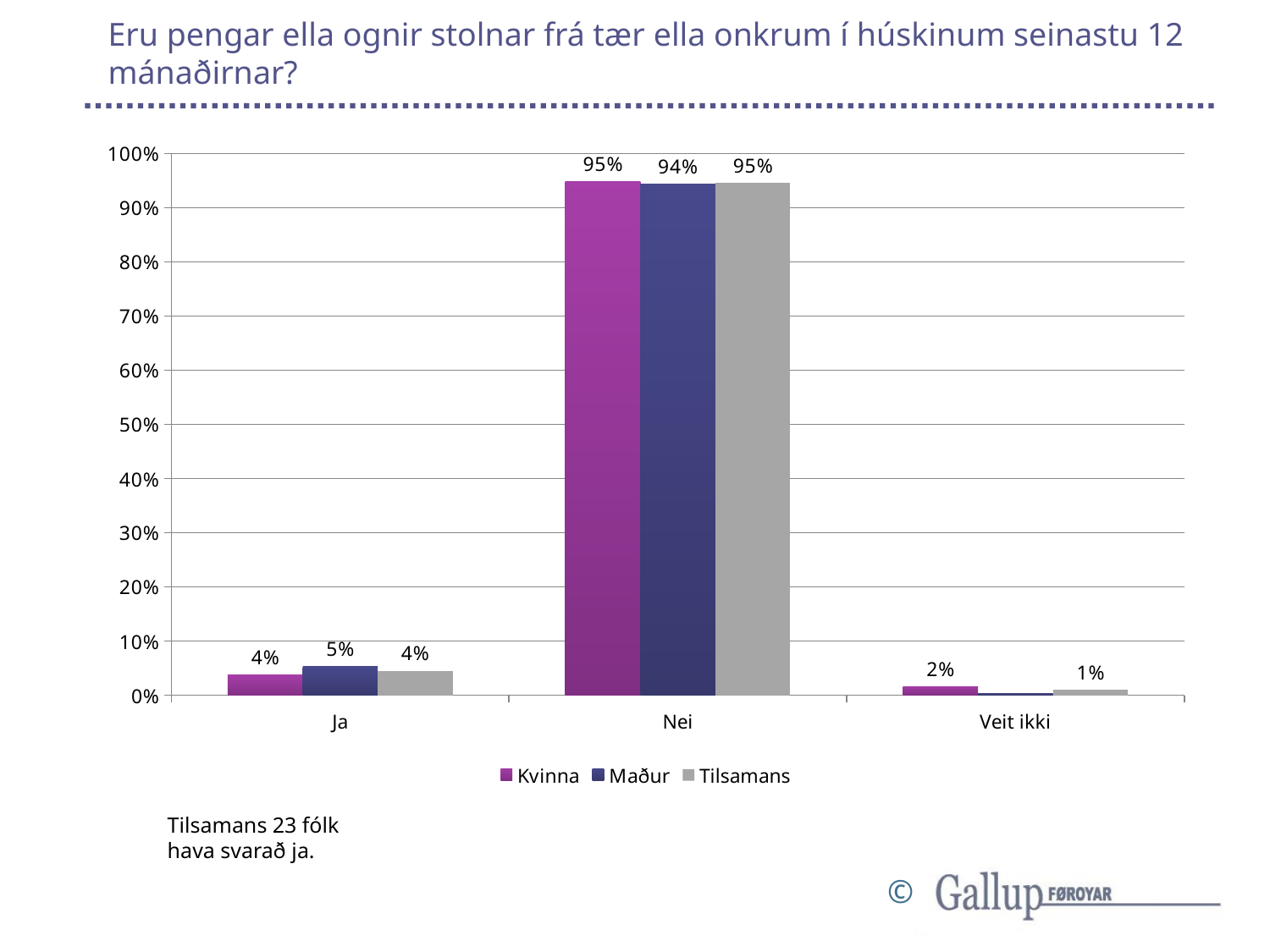
Which category has the lowest value for Kvinna? Veit ikki What is the value for Kvinna in the Veit ikki category? 2% Which is larger: the Kvinna value for Ja or the Maður value for Ja? Maður Which category has the highest value for Tilsamans? Nei How many categories are shown on the x axis? 3 Is the value for Maður in the Nei category greater or less than 90%? greater What is the value for Maður in the Ja category? 5% What is the difference between the Maður value for Nei and the Maður value for Ja? 89% How many series does the legend list? 3 What kind of chart is shown on the slide? bar chart What is the value for Tilsamans in the Veit ikki category? 1% What is the value for Kvinna in the Nei category? 95%